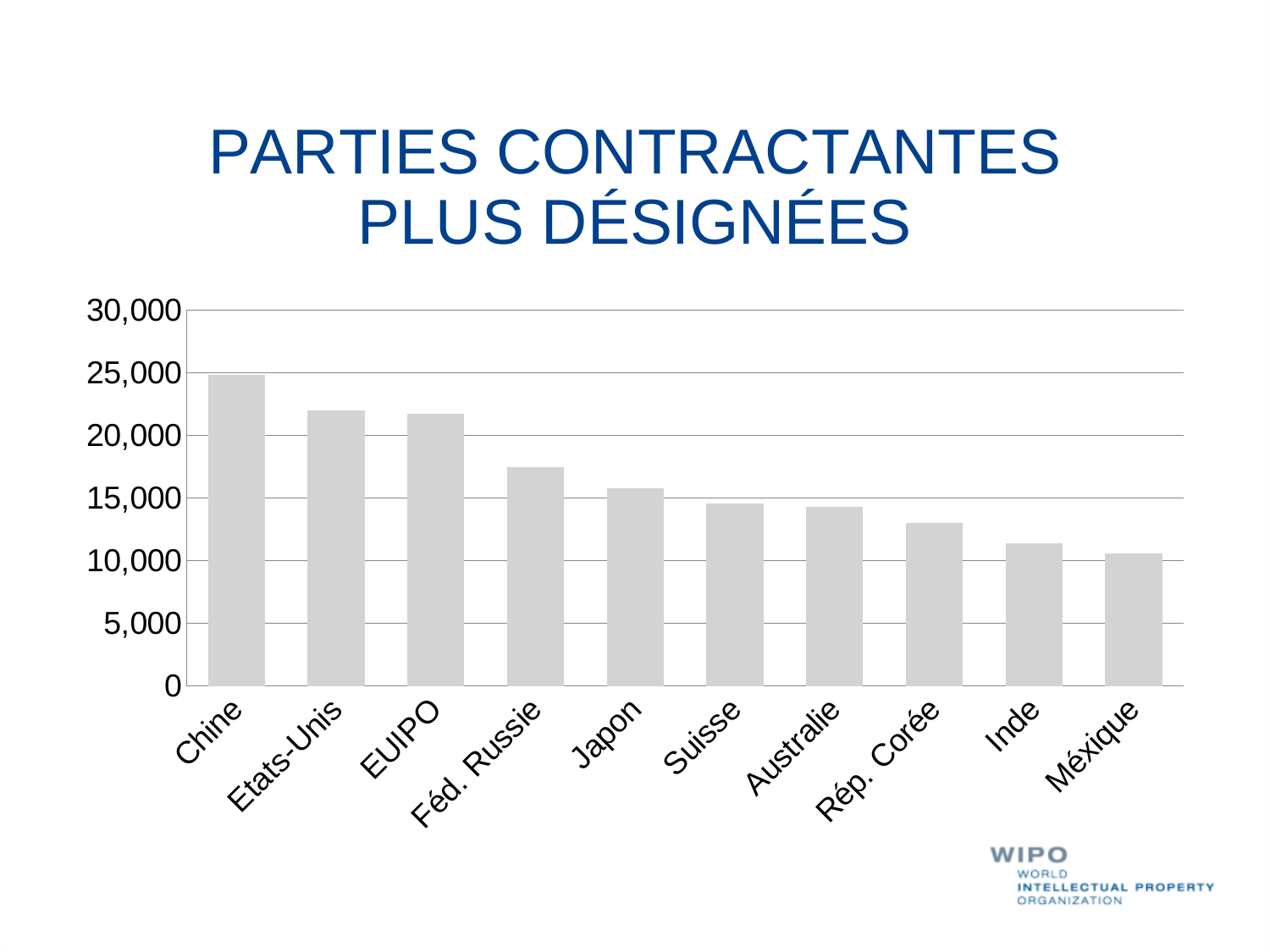
How many contracting parties are shown on the x axis? 10 What kind of chart is shown on the slide? Bar chart Is the value for Chine greater or less than 20,000? greater Which contracting party has the lowest bar in the chart? Méxique Do the values rise or fall moving from left to right along the x axis? Fall Is the value for Féd. Russie greater or less than 15,000? greater Which is larger, the value for Chine or the value for Etats-Unis? Chine What is the title of the slide containing the chart? PARTIES CONTRACTANTES PLUS DÉSIGNÉES Which contracting party has the highest bar in the chart? Chine Is the value for Rép. Corée greater or less than 15,000? less